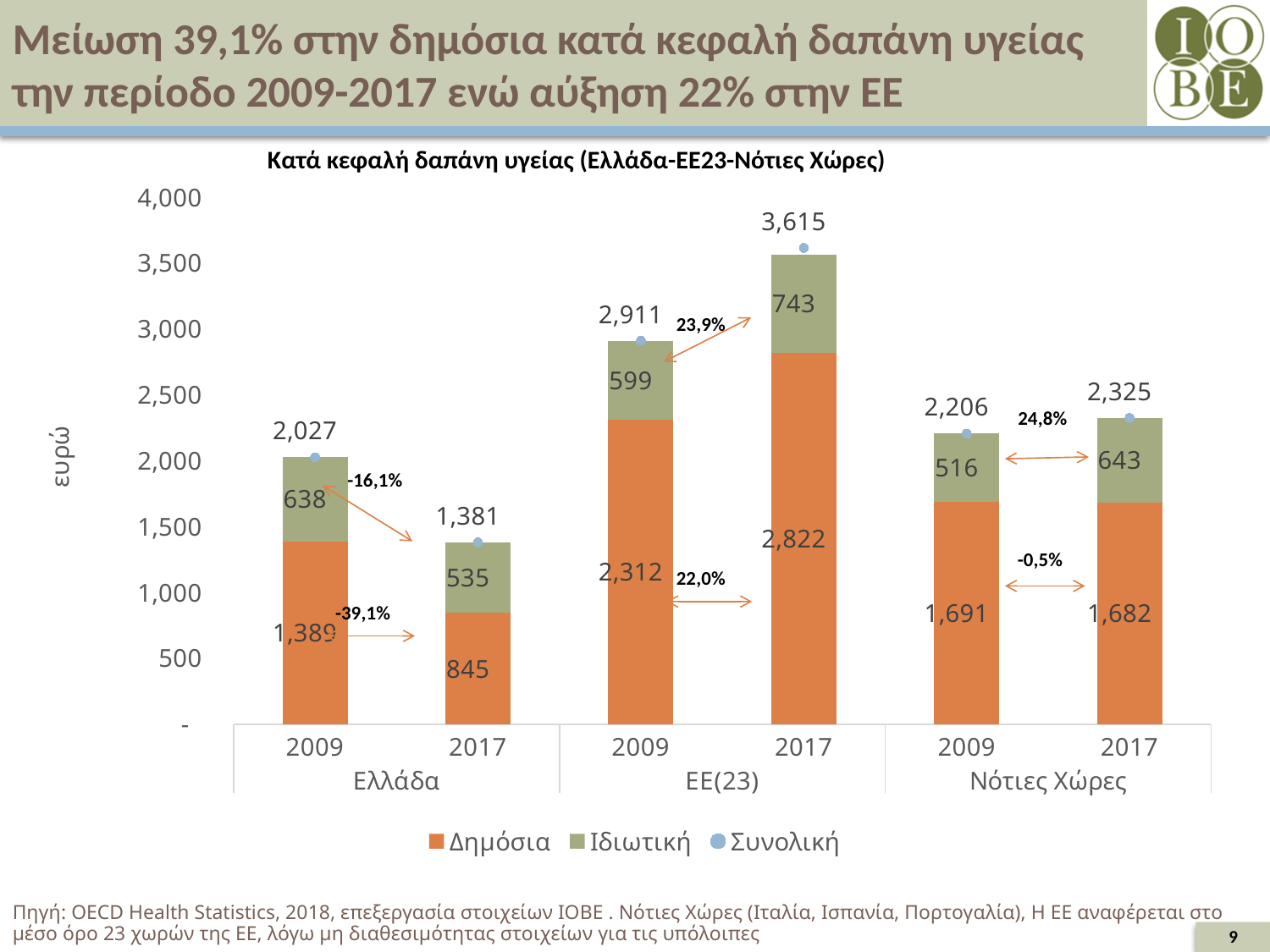
Which is larger: the private expenditure for Ελλάδα in 2009 or for Νότιες Χώρες in 2017? Νότιες Χώρες 2017 (643) What kind of chart is shown on the slide? Stacked bar chart Which group and year has the highest total (Συνολική) per capita health expenditure? ΕΕ(23) 2017 What is the percentage change in public expenditure for Ελλάδα between 2009 and 2017 shown on the chart? -39,1% Which group and year has the lowest total (Συνολική) per capita health expenditure? Ελλάδα 2017 How many series does the legend list? 3 What is the private (Ιδιωτική) per capita health expenditure for ΕΕ(23) in 2017? 743 What is the public (Δημόσια) per capita health expenditure for ΕΕ(23) in 2009? 2,312 What is the total (Συνολική) per capita health expenditure for Νότιες Χώρες in 2009? 2,206 How many bars are plotted in the chart? 6 What is the public (Δημόσια) per capita health expenditure for Ελλάδα in 2017? 845 What is the difference between the total per capita health expenditure for Ελλάδα in 2009 and in 2017? 646